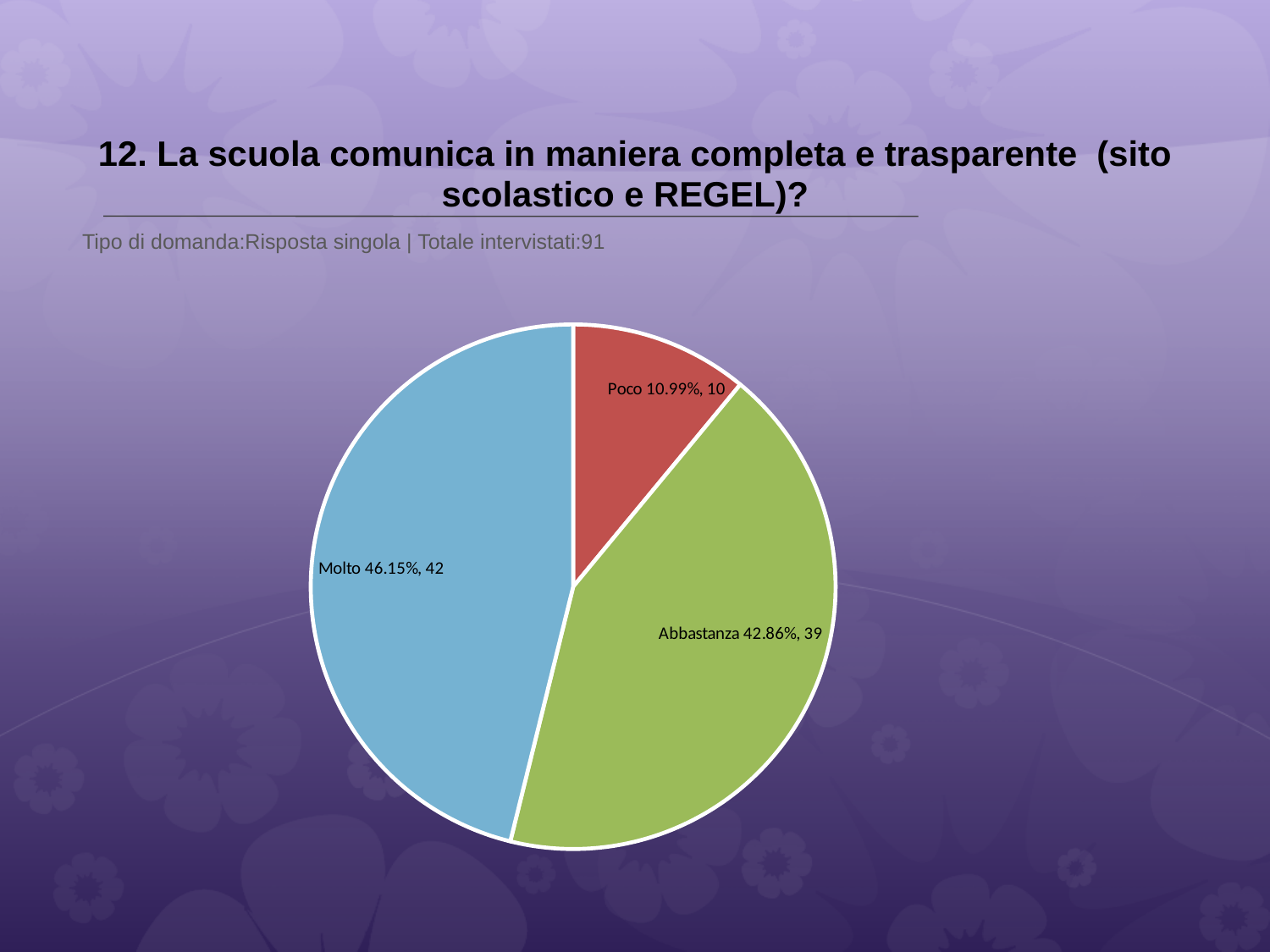
How many more respondents answered "Molto" than "Abbastanza"? 3 What colour is the "Molto" slice? blue How many respondents answered "Poco"? 10 How many respondents answered "Abbastanza"? 39 Which response has the smallest share of the pie? Poco What percentage of respondents answered "Poco"? 10.99% How many slices does the pie chart have? 3 What kind of chart is shown on the slide? pie chart What is the total number of respondents shown in the subtitle? 91 Which response has the largest share of the pie? Molto What percentage of respondents answered "Molto"? 46.15% Which has more respondents, "Abbastanza" or "Poco"? Abbastanza